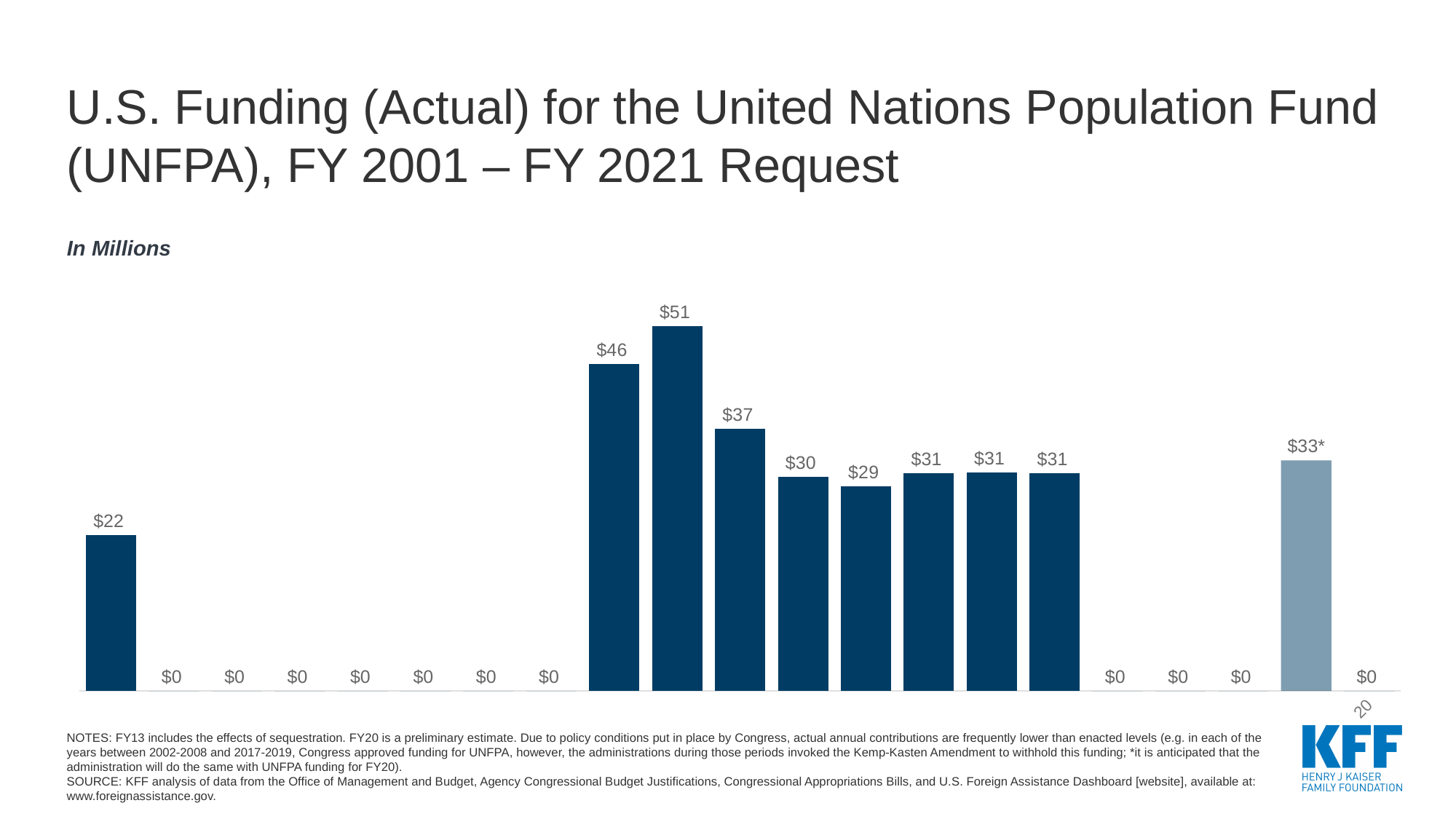
What unit does the subtitle say the values are in? In Millions What kind of chart is shown on the slide? bar chart What is the highest value shown in the chart? $51 What is the value of the first (leftmost) bar in the chart? $22 How many bars in the chart are labeled $0? 11 What is the value of the lighter-colored bar near the right end of the chart? $33* What is the value of the last (rightmost) bar in the chart? $0 What is the lowest non-zero value shown in the chart? $22 How many bars (fiscal years) are plotted in the chart? 21 Which is larger: the bar labeled $37 or the bar labeled $29? $37 What is the difference between the tallest bar ($51) and the bar immediately to its left ($46)? $5